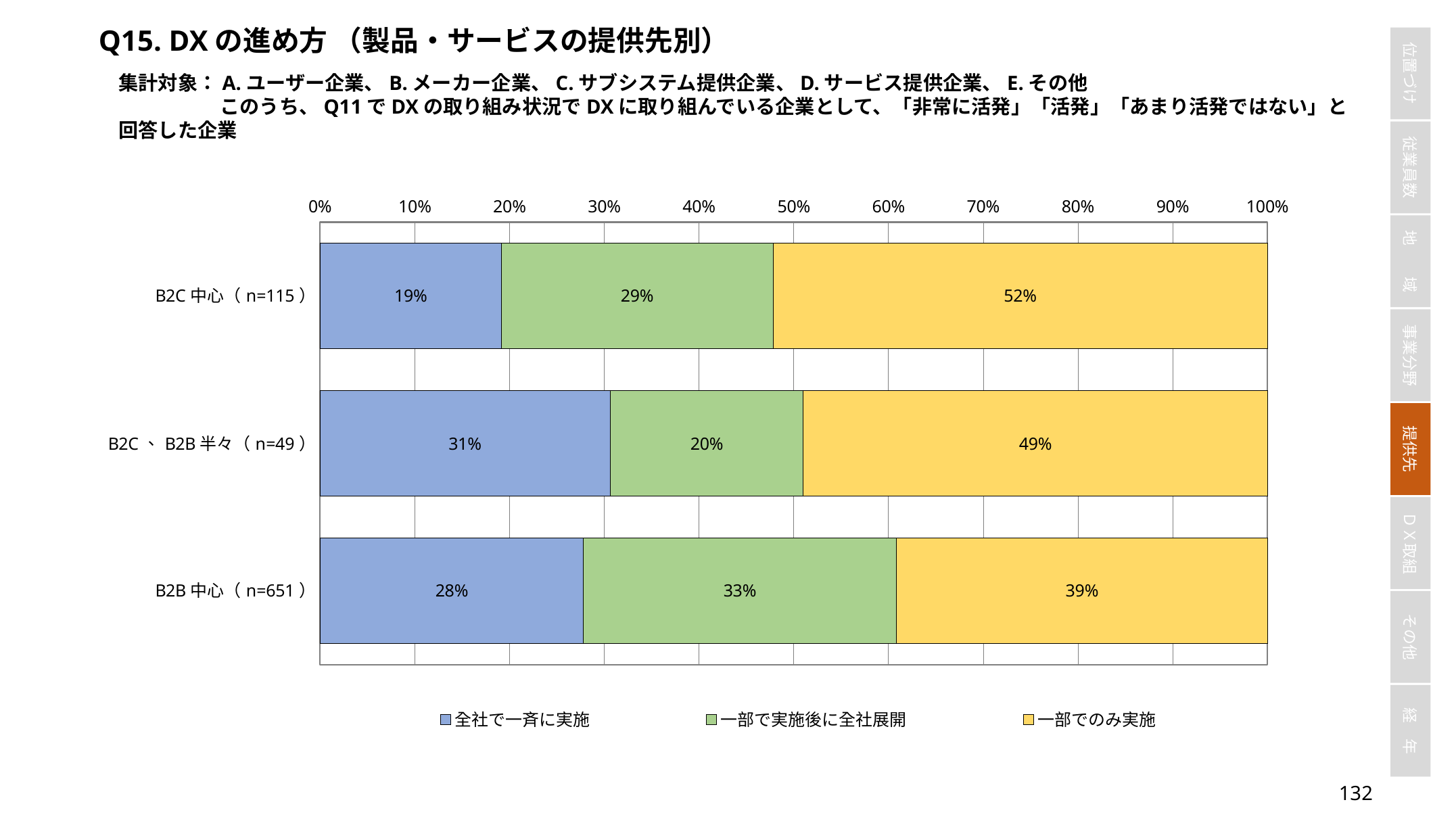
What is the value for 一部で実施後に全社展開 in the B2C、B2B 半々 (n=49) category? 20% How many categories are shown on the chart? 3 Which colour represents 一部で実施後に全社展開 in the chart? Green Which category has the highest value for 一部でのみ実施? B2C 中心 (n=115) What is the value for 一部でのみ実施 in the B2B 中心 (n=651) category? 39% What kind of chart is shown on the slide? Stacked bar chart Which category has the lowest value for 全社で一斉に実施? B2C 中心 (n=115) What is the value for 全社で一斉に実施 in the B2C 中心 (n=115) category? 19% Which is larger: the 全社で一斉に実施 value for B2C、B2B 半々 (n=49) or for B2B 中心 (n=651)? B2C、B2B 半々 (n=49) What is the difference between the 一部でのみ実施 values for B2C 中心 (n=115) and B2B 中心 (n=651)? 13% Is the 一部でのみ実施 value for B2C、B2B 半々 (n=49) greater or less than 40%? greater How many series does the legend list? 3